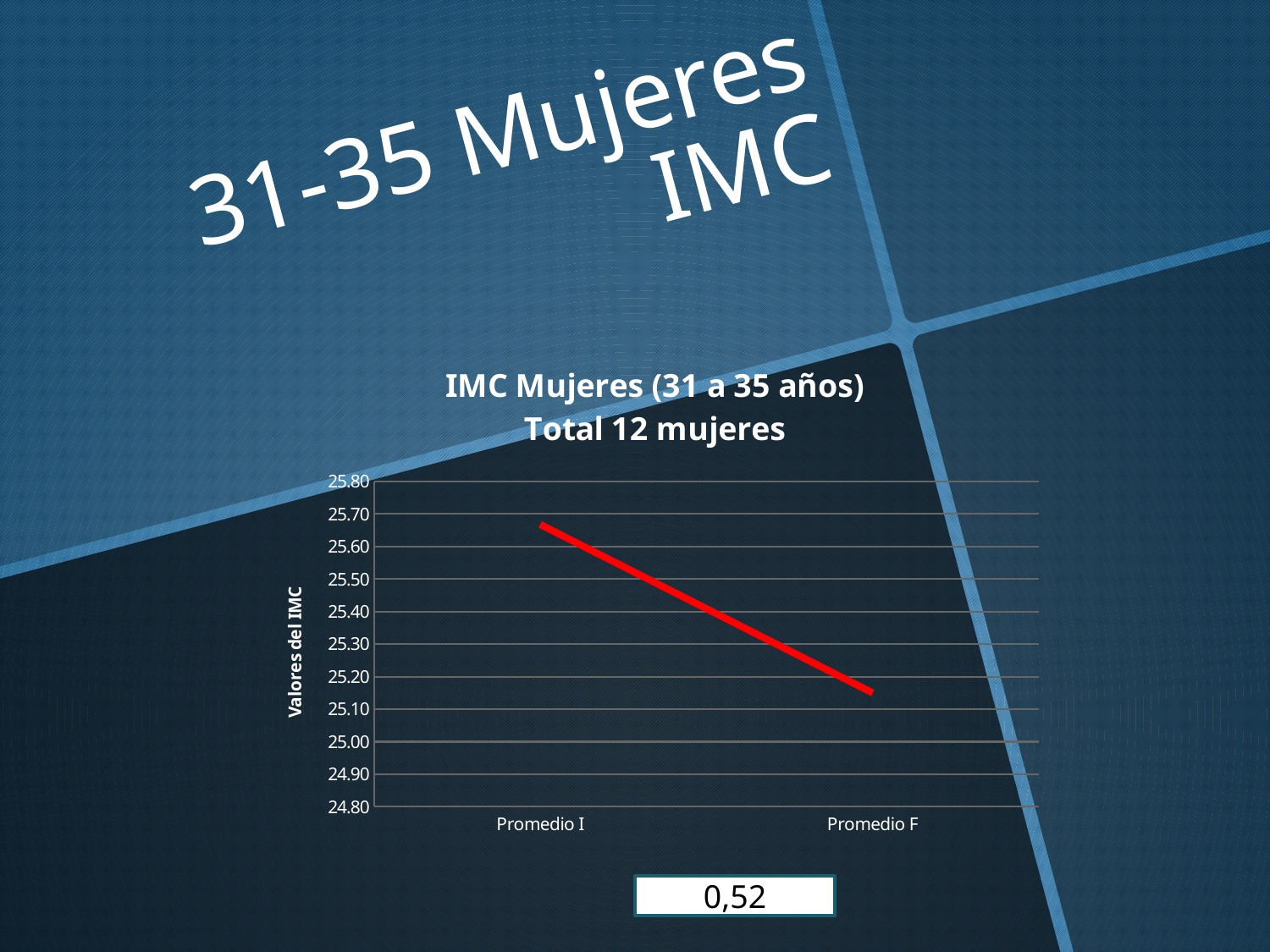
What is the label of the vertical axis? Valores del IMC Is the value for Promedio I greater or less than 25.50? greater Is the value for Promedio I greater or less than 25.80? less Does the line rise or fall from Promedio I to Promedio F? fall What kind of chart is shown on the slide? line chart Which category has the higher value, Promedio I or Promedio F? Promedio I Which category has the highest value? Promedio I How many points are plotted on the line? 2 Which category has the lowest value? Promedio F What is the title of the chart? IMC Mujeres (31 a 35 años) Total 12 mujeres Is the value for Promedio F greater or less than 25.00? greater